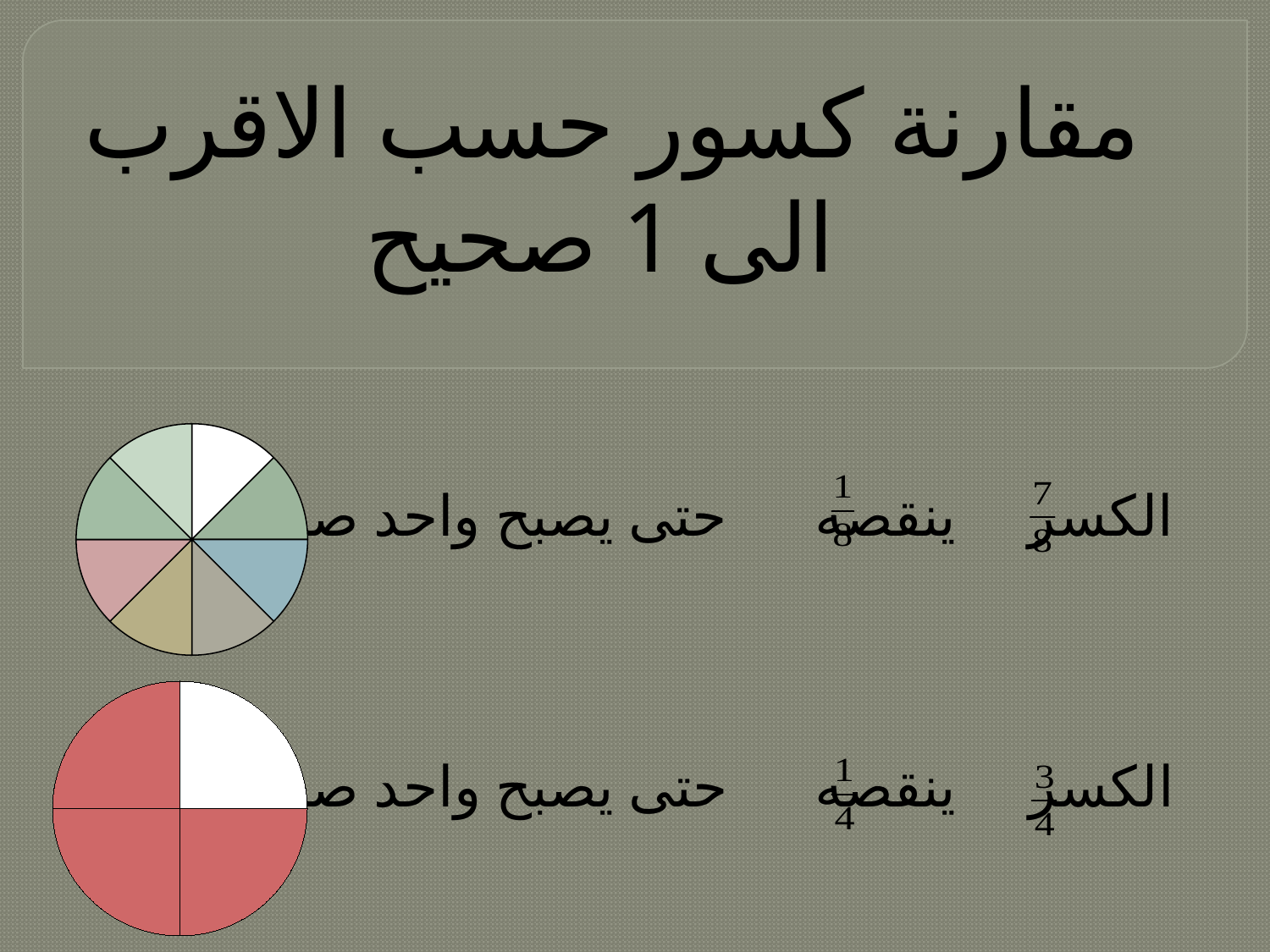
Which pie chart is divided into more slices, the top one or the bottom one? the top one What share of the top pie chart is the white slice? 1/8 What kind of chart is the bottom chart on the slide? pie chart What kind of chart is the top chart on the slide? pie chart According to the slide text, what fraction does the bottom pie chart represent? 3/4 How many slices does the top pie chart have? 8 How many slices does the bottom pie chart have? 4 According to the slide text, what fraction does the top pie chart represent? 7/8 What share of the bottom pie chart is the white slice? 1/4 How many slices in the top pie chart are white (unshaded)? 1 What colour are the shaded slices in the bottom pie chart? red